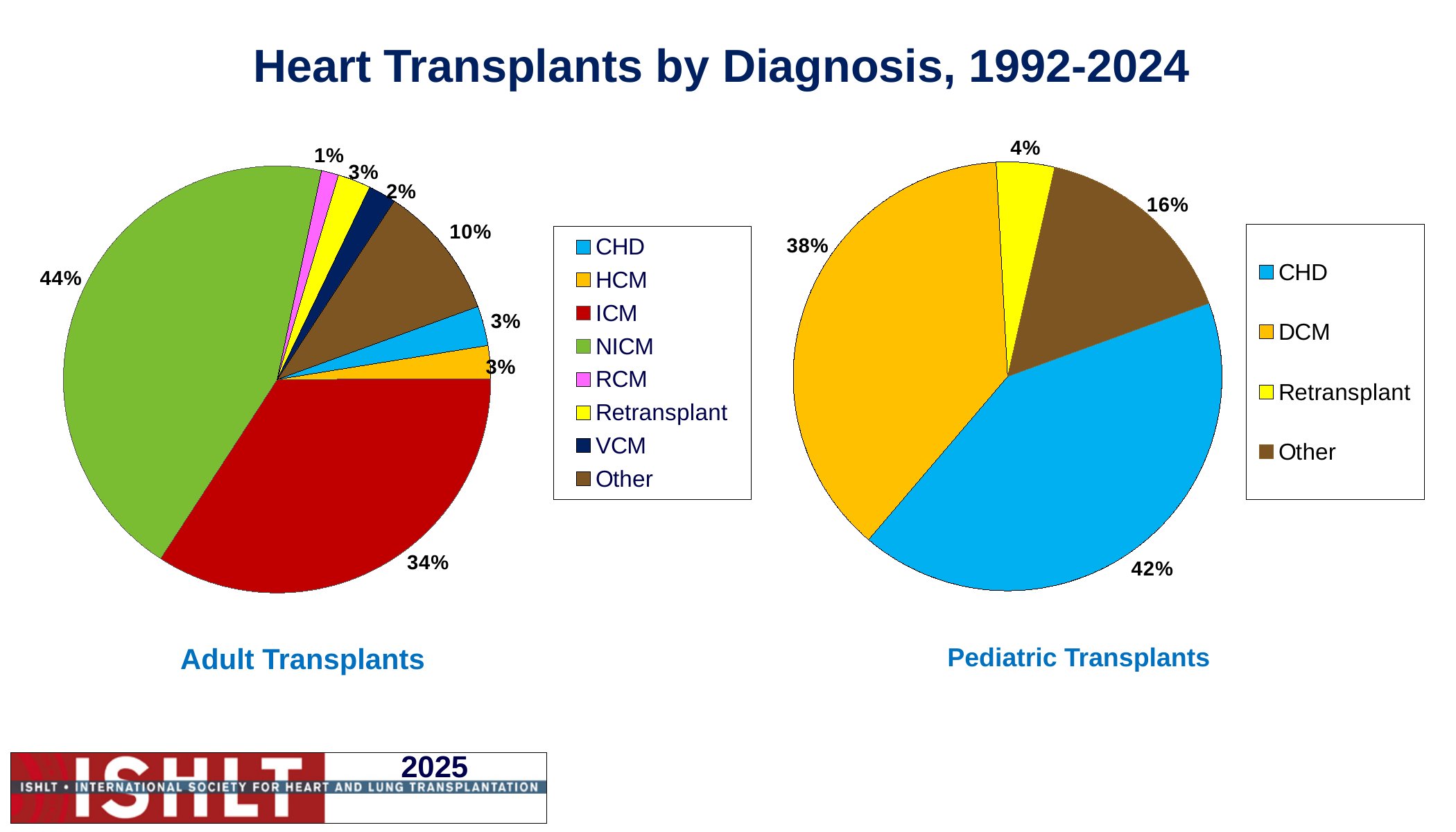
What type of chart is used for the Adult Transplants data? Pie chart In the Pediatric Transplants pie chart, which is larger, Other or Retransplant? Other In the Adult Transplants pie chart, how many diagnosis categories does the legend list? 8 In the Pediatric Transplants pie chart, how many categories does the legend list? 4 In the Pediatric Transplants pie chart, what share is CHD? 42% In the Adult Transplants pie chart, what share is NICM? 44% In the Adult Transplants pie chart, which diagnosis has the largest slice? NICM In the Pediatric Transplants pie chart, what share is DCM? 38% In the Pediatric Transplants pie chart, which diagnosis has the smallest slice? Retransplant In the Adult Transplants pie chart, which diagnosis has the smallest slice? RCM In the Adult Transplants pie chart, what is the difference between the NICM and ICM shares? 10%